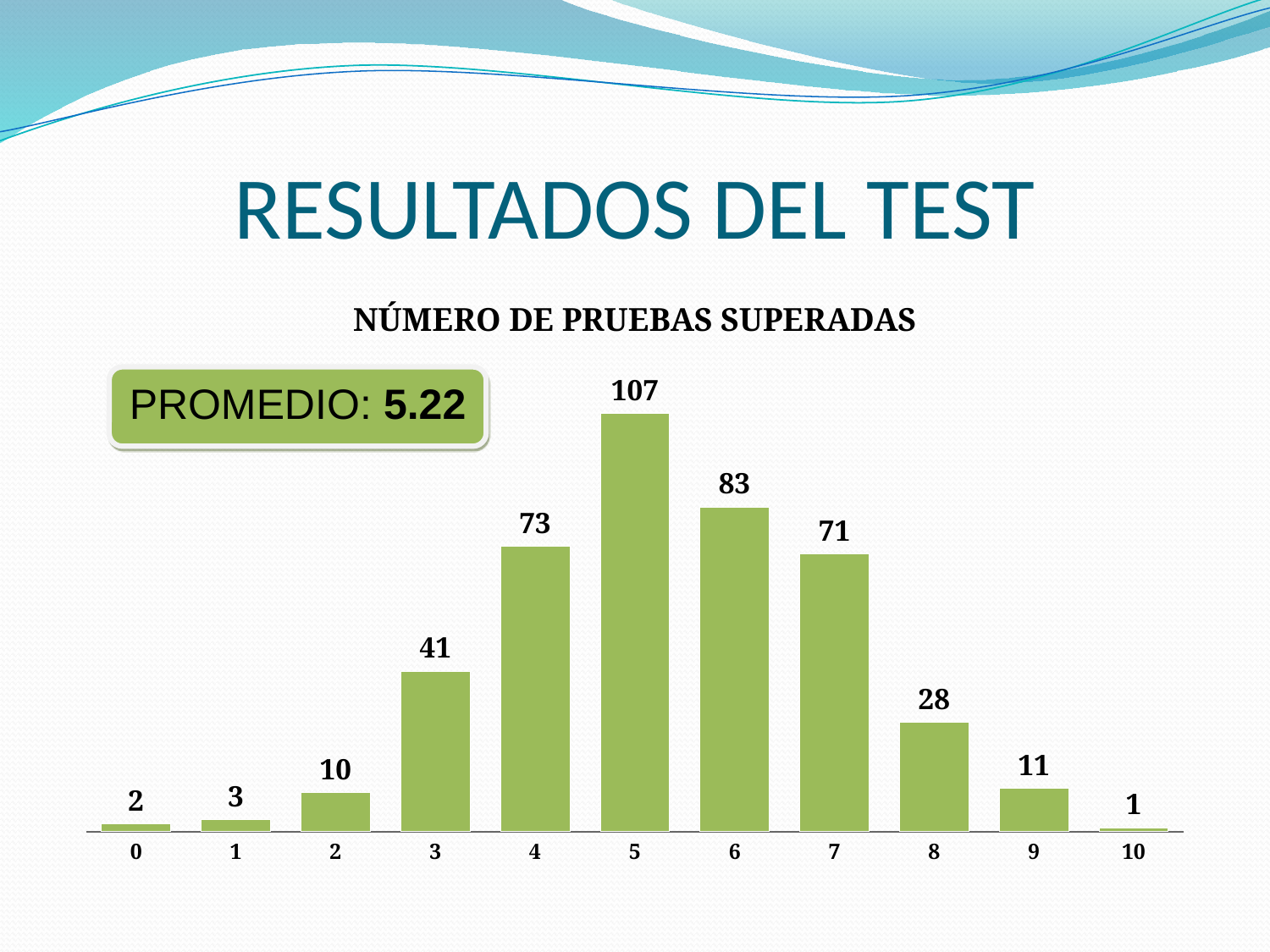
What is the difference between the values for categories 5 and 6? 24 Do the values rise or fall from category 5 to category 10? fall Which category has the lowest value? 10 What is the title of the chart? NÚMERO DE PRUEBAS SUPERADAS What is the value for category 5? 107 How many categories are shown on the x axis? 11 What is the value for category 8? 28 Which is larger, the value for category 6 or the value for category 7? 6 Which category has the highest value? 5 What kind of chart is this? bar chart What is the value for category 3? 41 What is the difference between the values for categories 4 and 3? 32